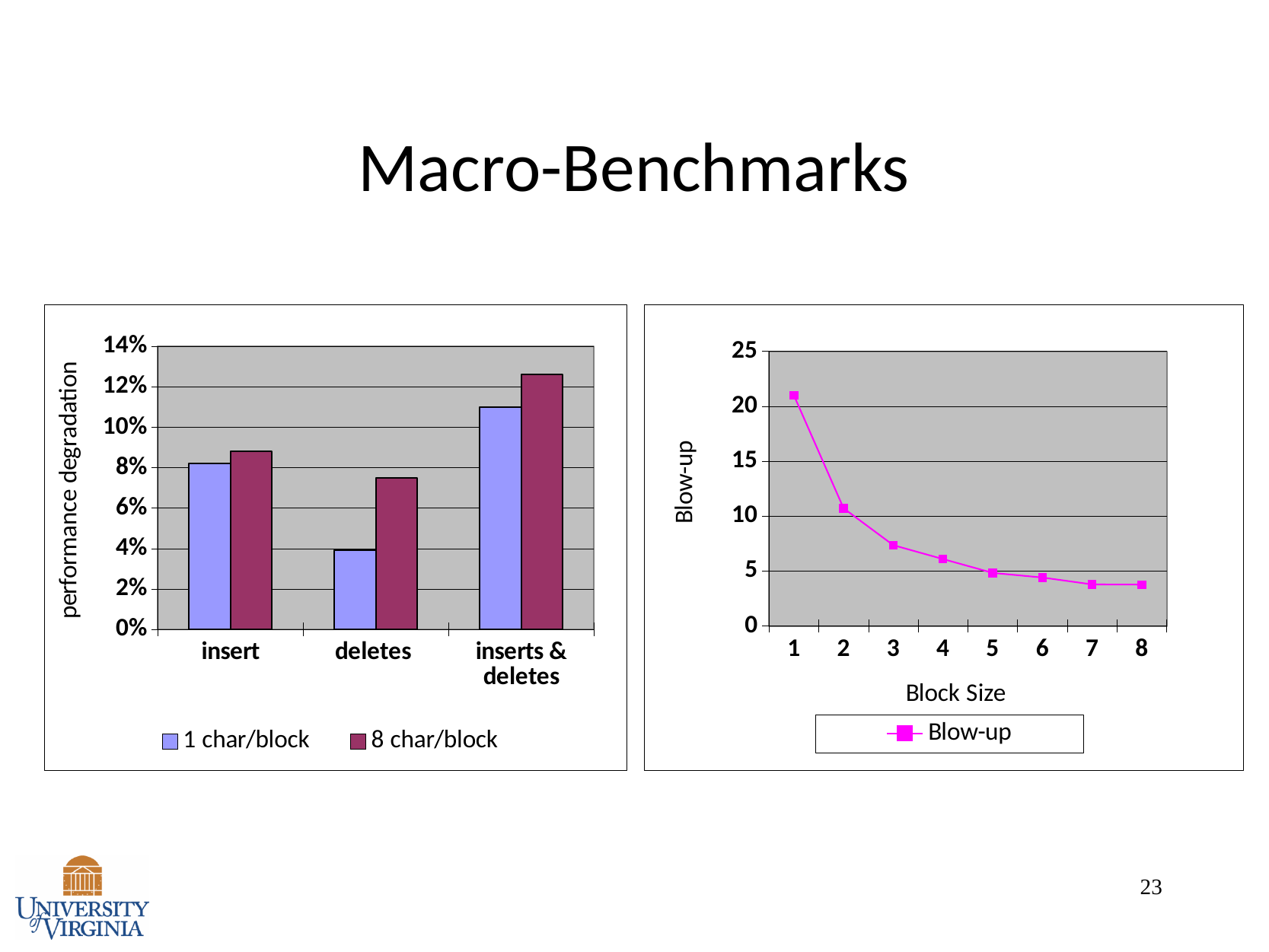
In the left chart, for deletes, which series has the larger value: 1 char/block or 8 char/block? 8 char/block In the left chart, is the 8 char/block value for inserts & deletes greater or less than 10%? greater In the right chart, is the Blow-up value at block size 1 greater or less than 15? greater In the right chart, how many block sizes are plotted on the x axis? 8 What kind of chart is the right chart (Blow-up vs Block Size)? line chart What kind of chart is the left chart on the slide? bar chart In the left chart, is the 1 char/block value for deletes greater or less than 6%? less In the left chart, which category has the highest performance degradation for 8 char/block? inserts & deletes In the right chart, does the Blow-up rise or fall as Block Size increases? fall In the left chart, which category has the lowest performance degradation for 1 char/block? deletes How many series does the legend of the left chart list? 2 How many categories are shown on the x axis of the left chart? 3